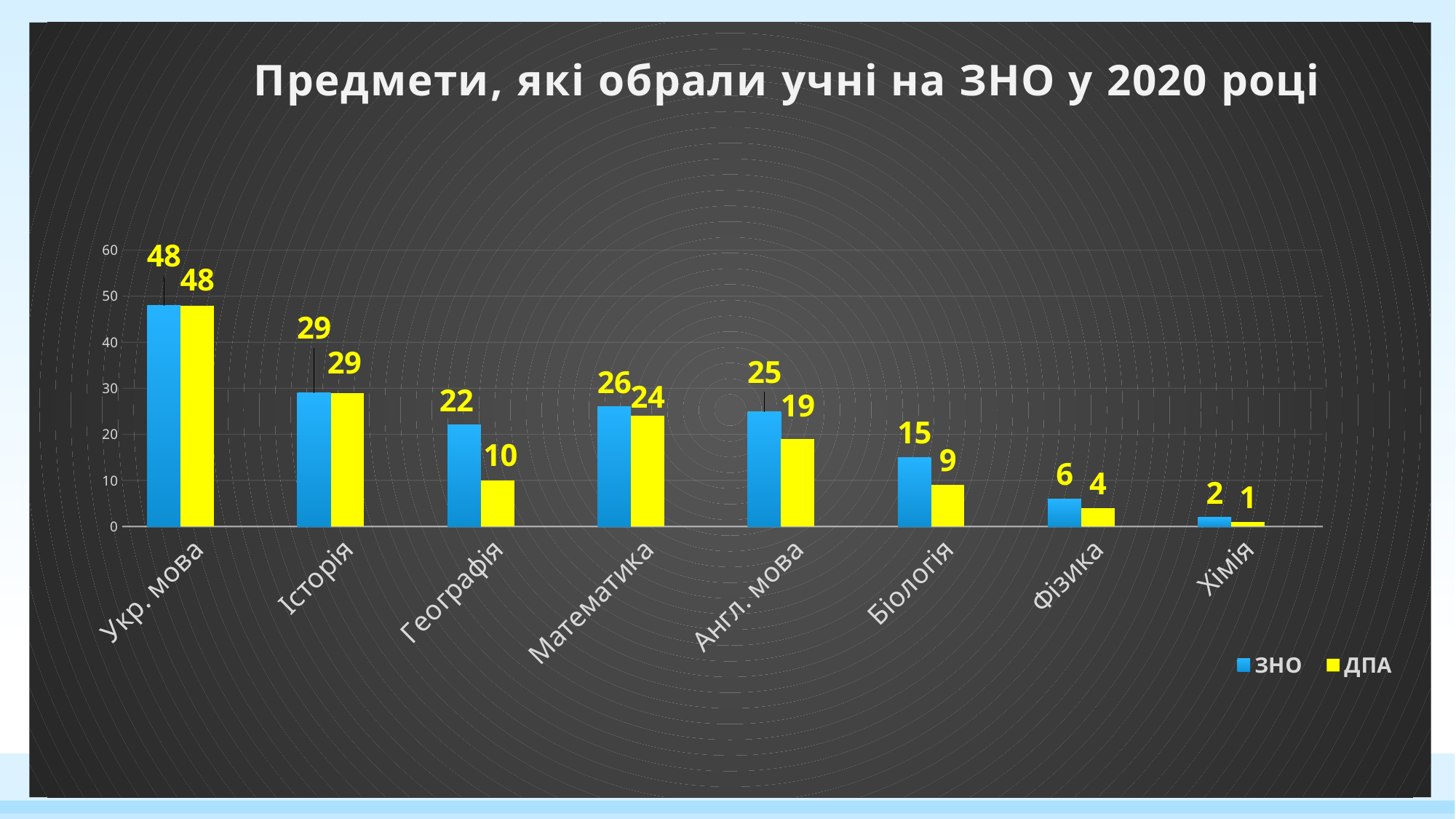
How many series does the legend list? 2 What is the title of the chart? Предмети, які обрали учні на ЗНО у 2020 році What is the ДПА value for Англ. мова? 19 What is the ЗНО value for Географія? 22 Which category has the lowest ДПА value? Хімія What is the ДПА value for Математика? 24 How many categories are shown on the x axis? 8 Which is larger for Біологія: the ЗНО value or the ДПА value? ЗНО What is the difference between the ЗНО values for Укр. мова and Історія? 19 What kind of chart is shown on the slide? bar chart What is the difference between the ЗНО and ДПА values for Географія? 12 Which category has the highest ЗНО value? Укр. мова